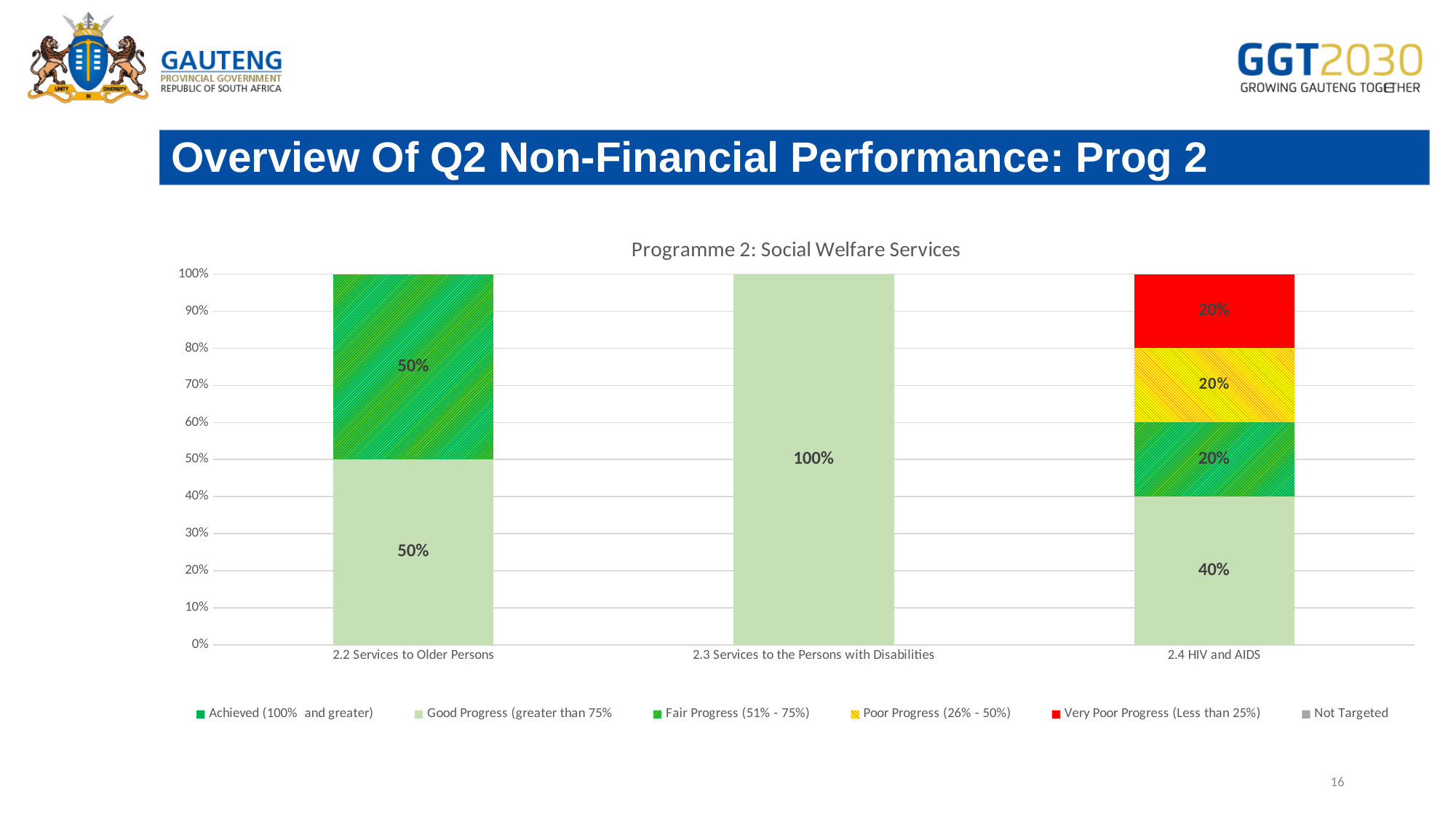
What kind of chart is shown on the slide? Stacked bar chart How many series does the chart's legend list? 6 What is the Good Progress (greater than 75%) value for 2.4 HIV and AIDS? 40% Which category has the lowest Good Progress (greater than 75%) value? 2.4 HIV and AIDS What is the title of the chart? Programme 2: Social Welfare Services What is the Fair Progress (51% - 75%) value for 2.2 Services to Older Persons? 50% How many categories are shown on the x axis of the chart? 3 Which category has the highest Good Progress (greater than 75%) value? 2.3 Services to the Persons with Disabilities Which category has the larger Good Progress (greater than 75%) value, 2.2 Services to Older Persons or 2.4 HIV and AIDS? 2.2 Services to Older Persons What is the Very Poor Progress (Less than 25%) value for 2.4 HIV and AIDS? 20% What is the Good Progress (greater than 75%) value for 2.3 Services to the Persons with Disabilities? 100% What is the difference between the Good Progress (greater than 75%) values for 2.2 Services to Older Persons and 2.4 HIV and AIDS? 10%